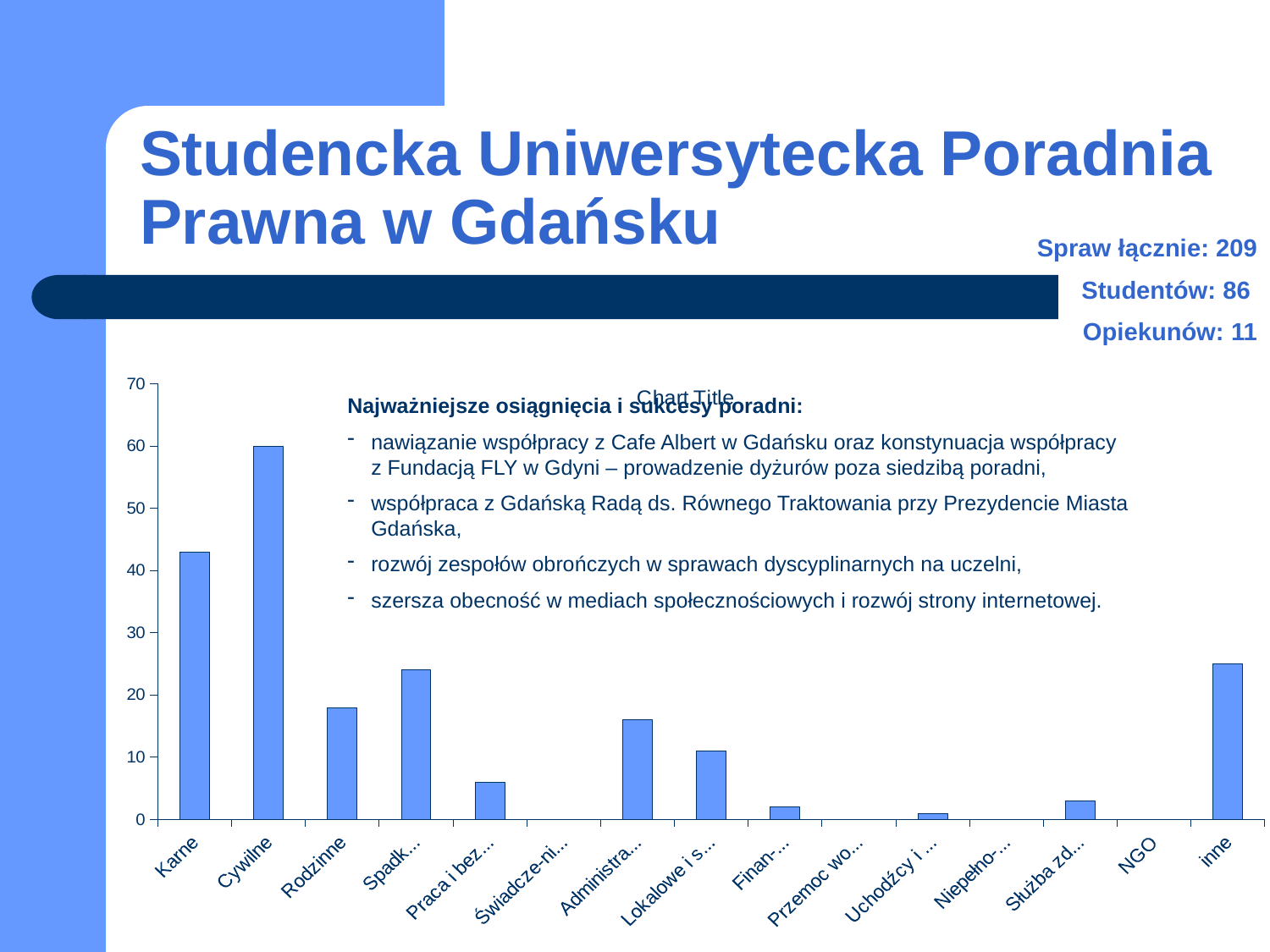
Is the value for Rodzinne greater or less than 20? less Which is larger, the value for Rodzinne or the value for Spadk...? Spadk... Is the value for Administra... greater or less than 20? less How many categories are shown on the x axis of the chart? 15 Is the value for inne greater or less than 20? greater Which category has the highest bar in the chart? Cywilne Which is larger, the value for Karne or the value for Cywilne? Cywilne What is the value for Cywilne in the chart? 60 What kind of chart is shown on the slide? bar chart What is the title shown above the chart? Chart Title